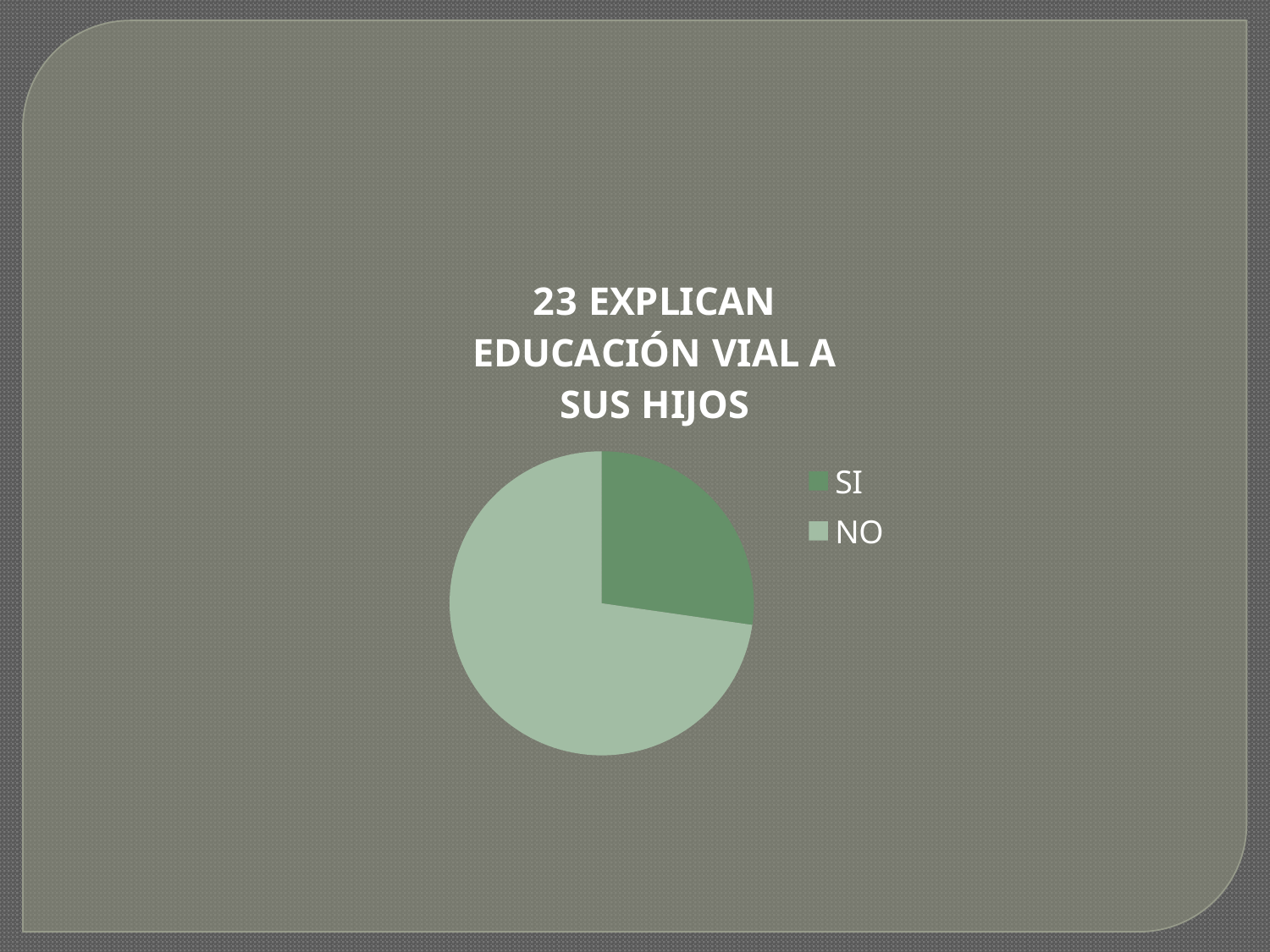
How many entries does the legend list? 2 What kind of chart is shown on the slide? pie chart Which slice is larger, SI or NO? NO How many slices does the pie chart have? 2 Which legend entry is shown in the darker green colour? SI What is the title of the chart? 23 EXPLICAN EDUCACIÓN VIAL A SUS HIJOS Which category has the smallest slice of the pie? SI Which category has the largest slice of the pie? NO